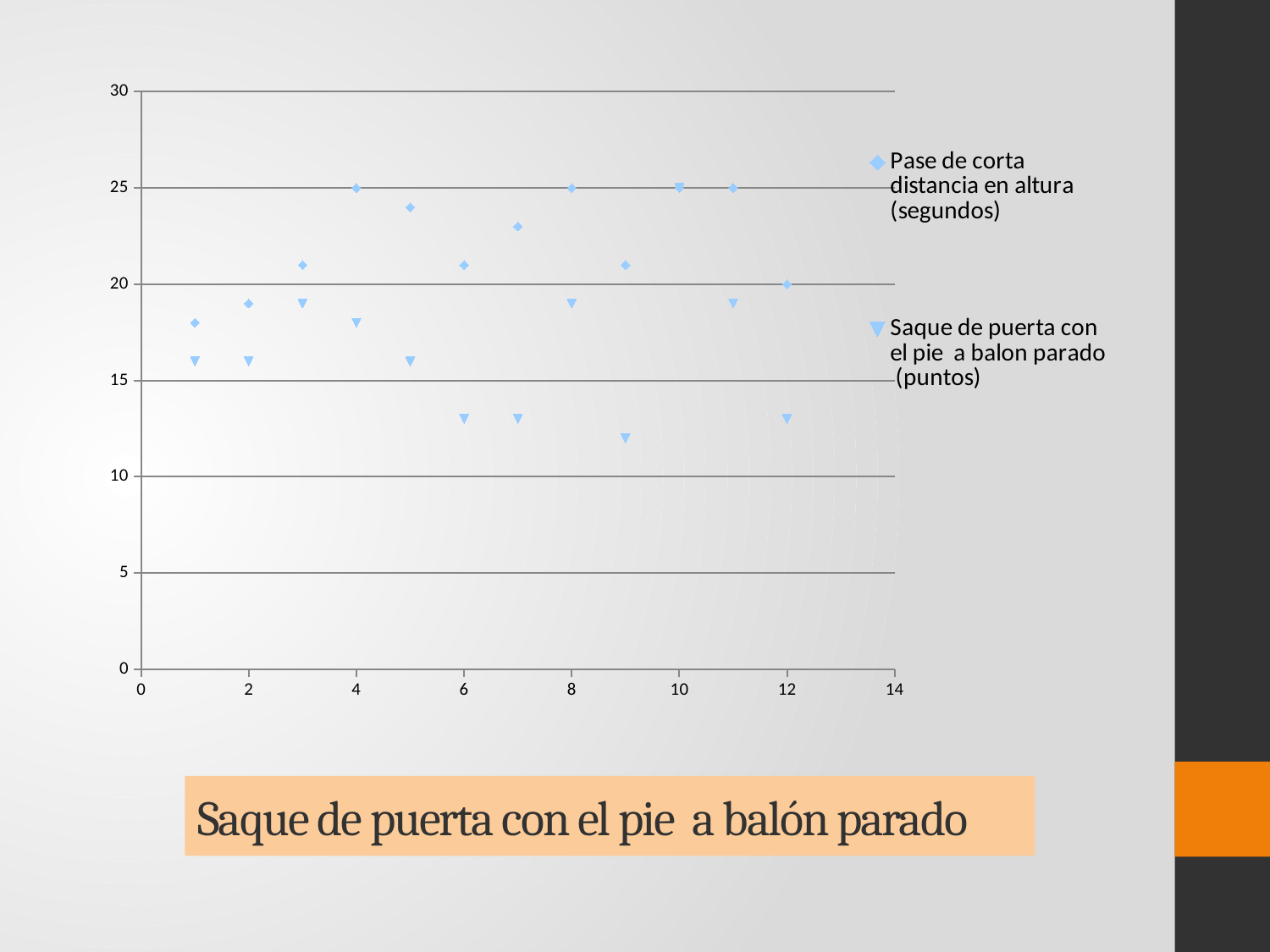
How many data points does the 'Pase de corta distancia en altura (segundos)' series have? 12 How many series does the legend list? 2 What is the highest value shown on the y axis? 30 Is the value for 'Saque de puerta con el pie a balon parado (puntos)' at x = 9 greater or less than 15? less What is the value of 'Pase de corta distancia en altura (segundos)' at x = 4? 25 At which x value does the 'Saque de puerta con el pie a balon parado (puntos)' series reach its highest value? 10 What is the value of 'Saque de puerta con el pie a balon parado (puntos)' at x = 10? 25 What is the value of 'Pase de corta distancia en altura (segundos)' at x = 12? 20 What kind of chart is shown on the slide? scatter chart At x = 6, which series has the higher value? Pase de corta distancia en altura (segundos) Is the value for 'Pase de corta distancia en altura (segundos)' at x = 1 greater or less than 15? greater Is the value for 'Saque de puerta con el pie a balon parado (puntos)' at x = 3 greater or less than 20? less